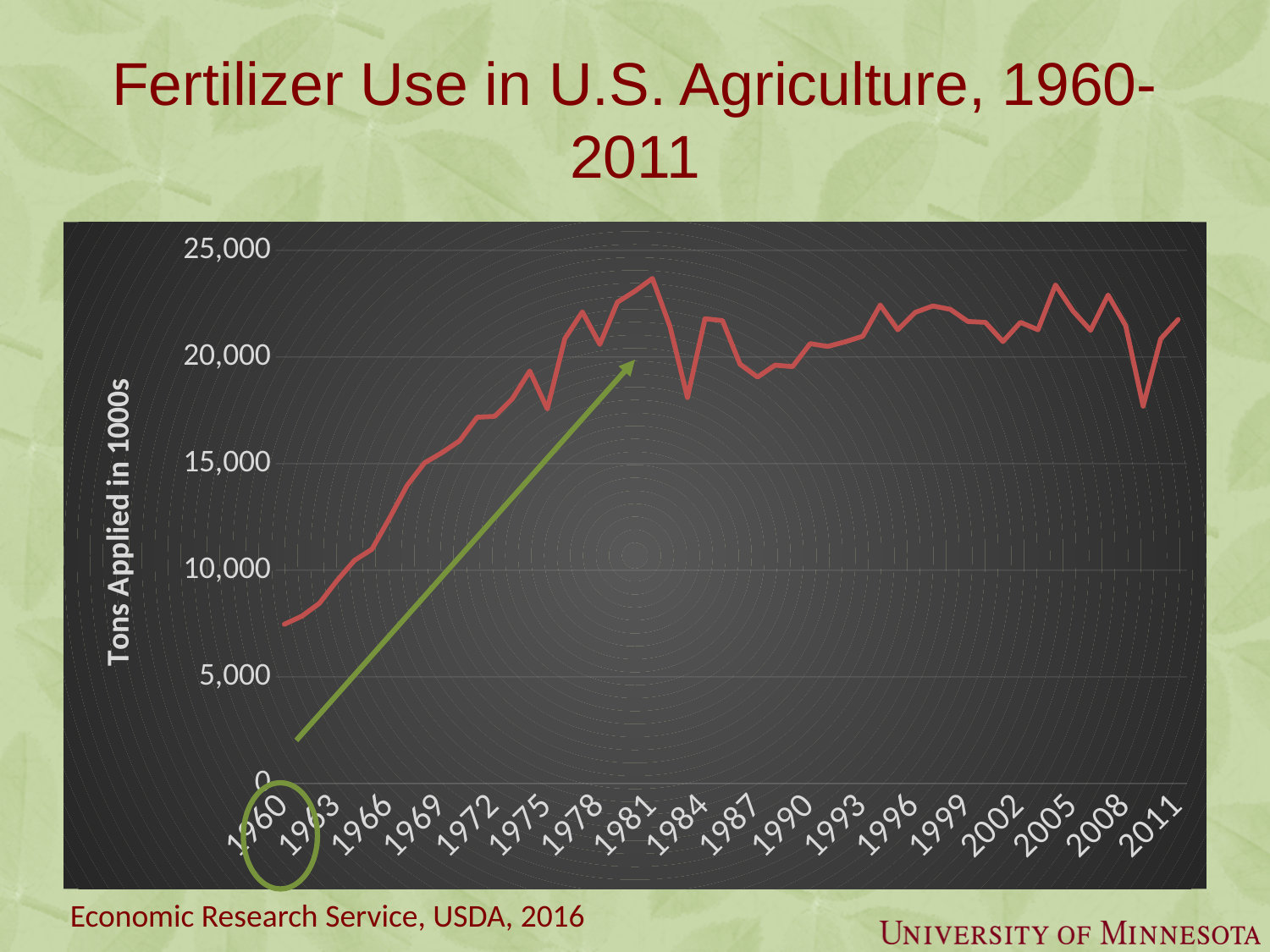
What is the title of the chart on the slide? Fertilizer Use in U.S. Agriculture, 1960-2011 Which is larger, the value for 1981 or the value for 1984? 1981 Is the value for 2011 greater or less than 20,000? greater Is the value for 1960 greater or less than 10,000? less Do the values rise or fall along the x axis between 1960 and 1981? rise Which is larger, the value for 1960 or the value for 2011? 2011 Which year has the lowest value on the chart? 1960 What kind of chart is shown on the slide? line chart What is the label on the vertical axis of the chart? Tons Applied in 1000s Is the value for 1975 greater or less than 15,000? greater